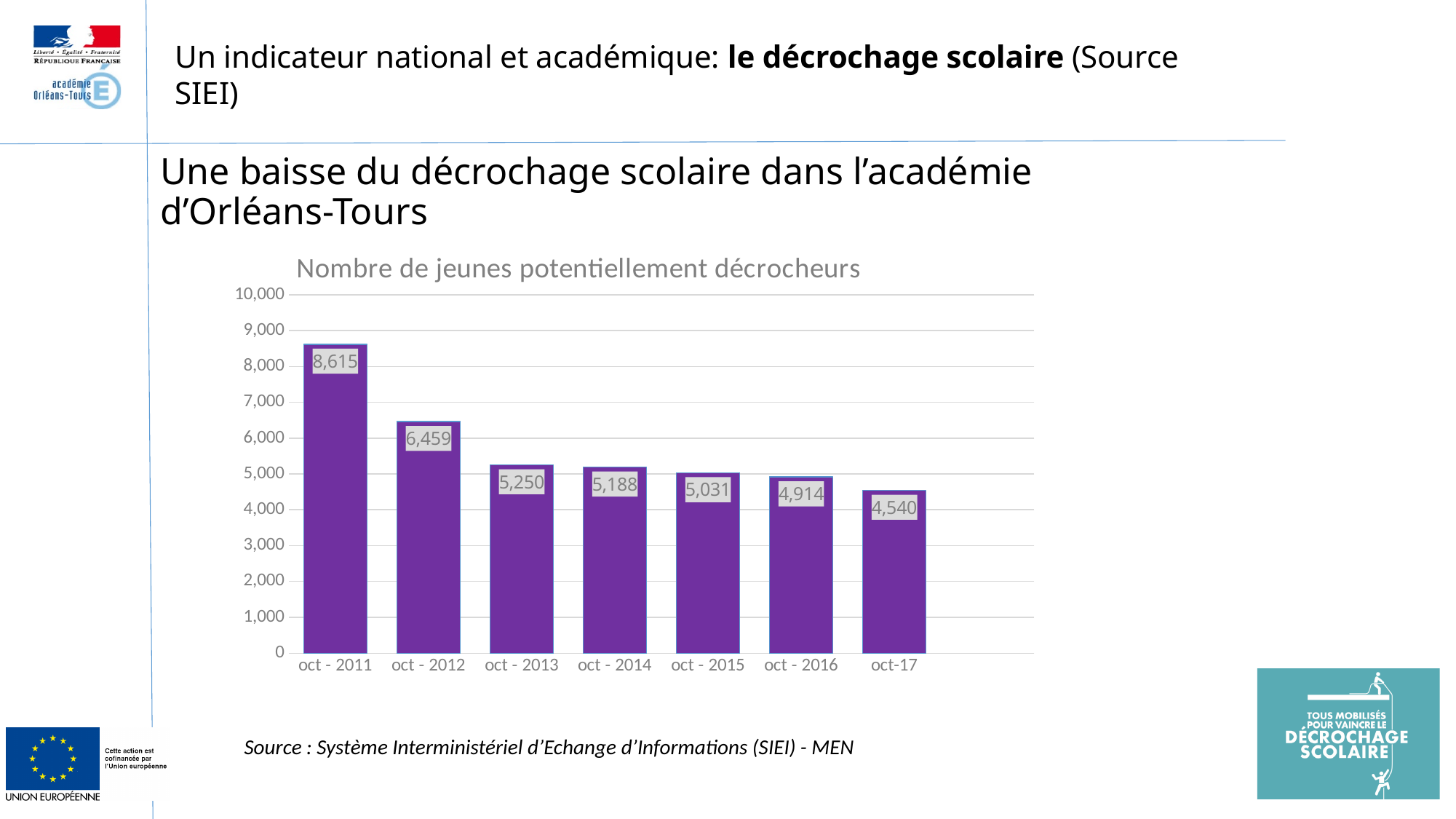
Do the values rise or fall from oct - 2011 to oct-17? fall How many categories are shown on the x axis? 7 What is the value for oct - 2011? 8,615 Is the value for oct - 2012 greater or less than 6,000? greater What kind of chart is shown on the slide? bar chart Which category has the highest value? oct - 2011 What is the value for oct-17? 4,540 Which category has the lowest value? oct-17 What is the difference between the values for oct - 2011 and oct - 2012? 2,156 What is the value for oct - 2014? 5,188 What is the difference between the values for oct - 2016 and oct-17? 374 Which is larger, the value for oct - 2013 or the value for oct - 2015? oct - 2013